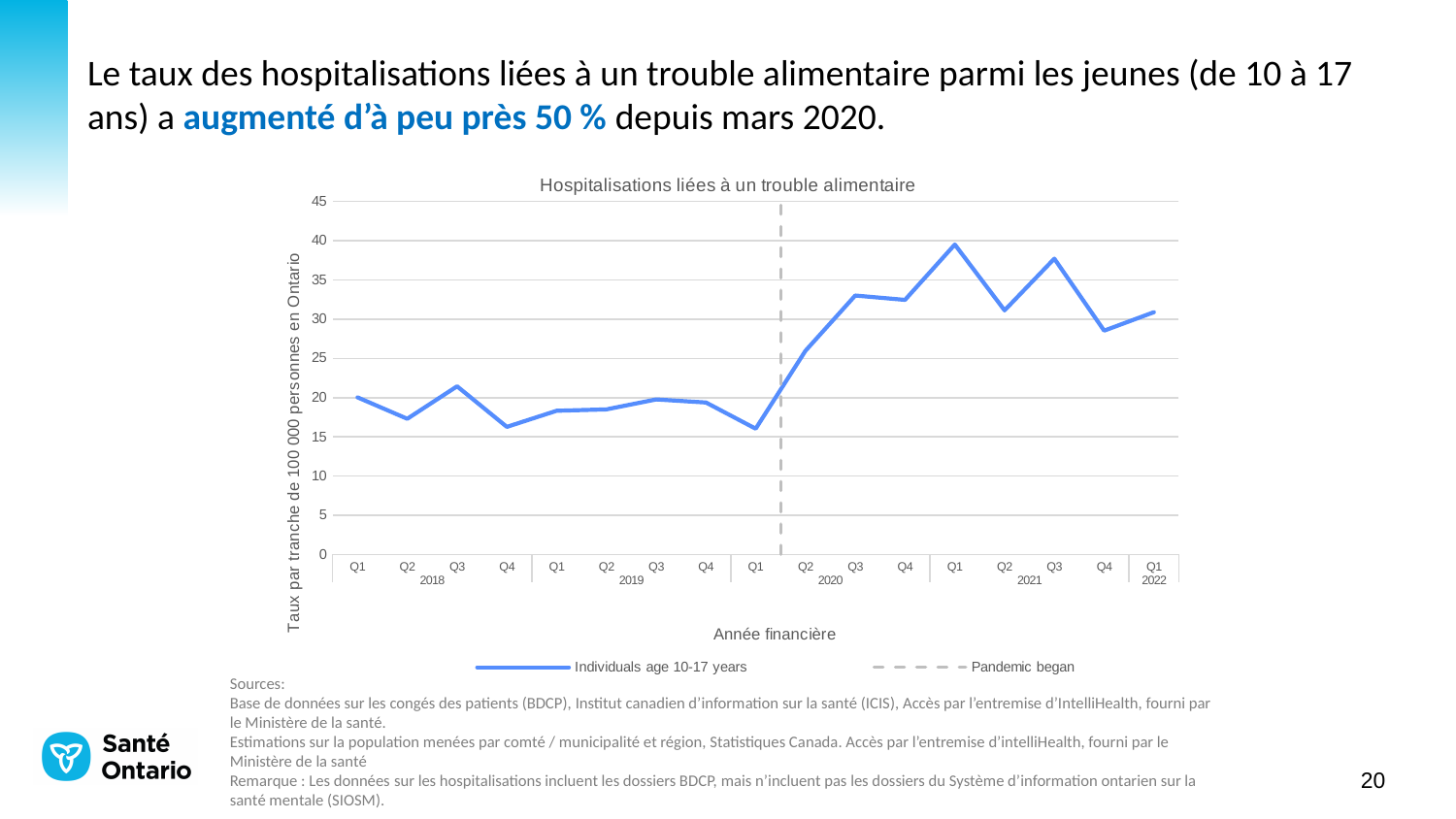
In which quarter does the hospitalisation rate reach its highest value? Q1 2021 Which is higher, the value for Q1 2021 or the value for Q3 2021? Q1 2021 Is the value for Q2 2018 greater or less than 20? less What is the label of the vertical axis of the chart? Taux par tranche de 100 000 personnes en Ontario How many entries does the chart legend list? 2 Is the value for Q1 2020 greater or less than 20? less Does the hospitalisation rate rise or fall between Q1 2020 and Q1 2021? Rise How many quarterly data points are plotted on the line? 17 What kind of chart is shown on the slide? Line chart Is the value for Q3 2020 greater or less than 30? greater What is the title of the chart? Hospitalisations liées à un trouble alimentaire